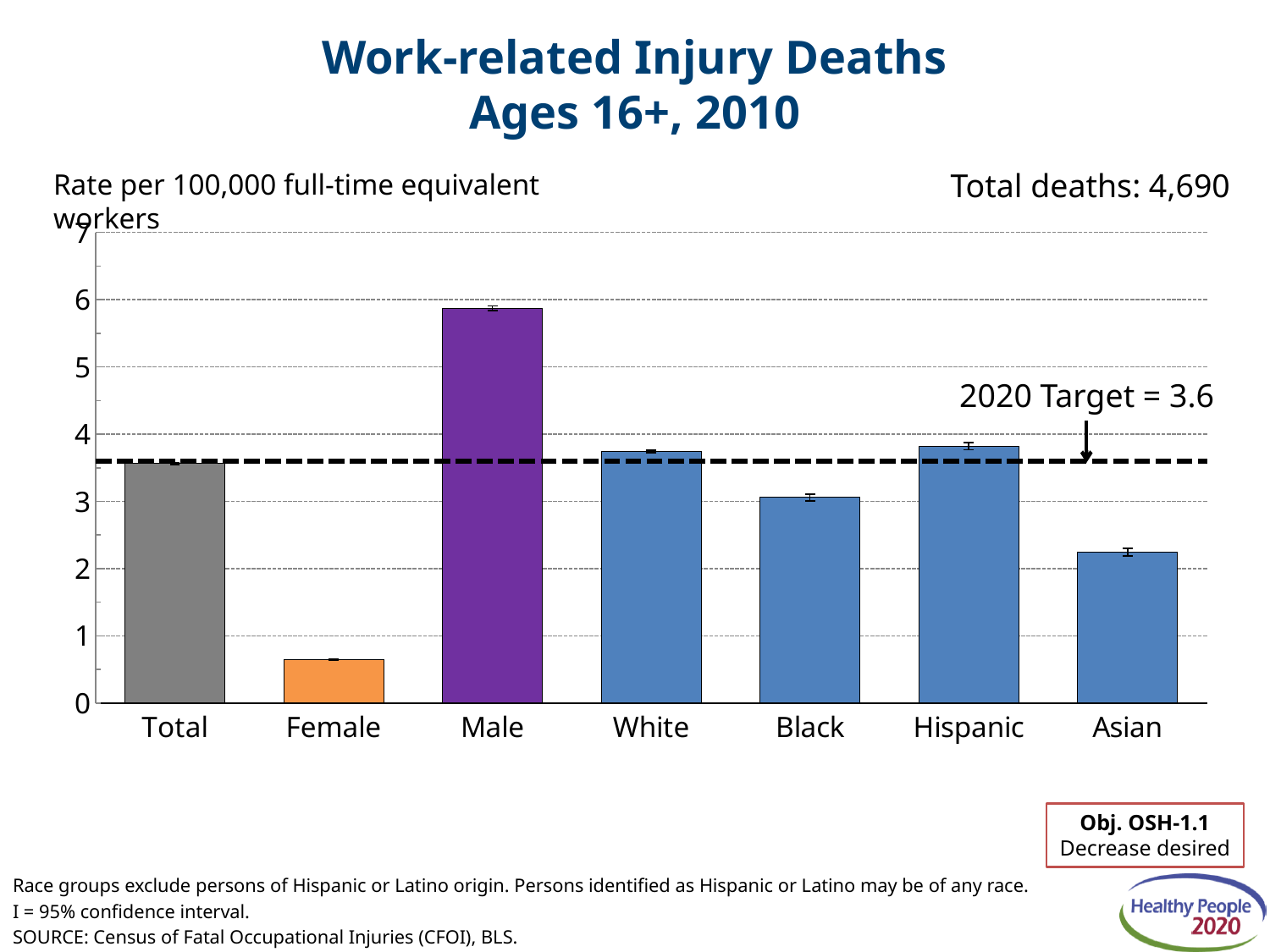
What is the total number of deaths stated on the slide? 4,690 Which is larger, the value for Black or the value for Asian? Black Which is larger, the value for Female or the value for Asian? Asian Is the value for Asian greater or less than 3? less What kind of chart is shown on the slide? bar chart Is the value for Female greater or less than 1? less Is the value for Male greater or less than 5? greater Which category has the lowest work-related injury death rate? Female Which category has the highest work-related injury death rate? Male How many categories are shown on the x axis of the chart? 7 What is the 2020 Target value shown on the chart? 3.6